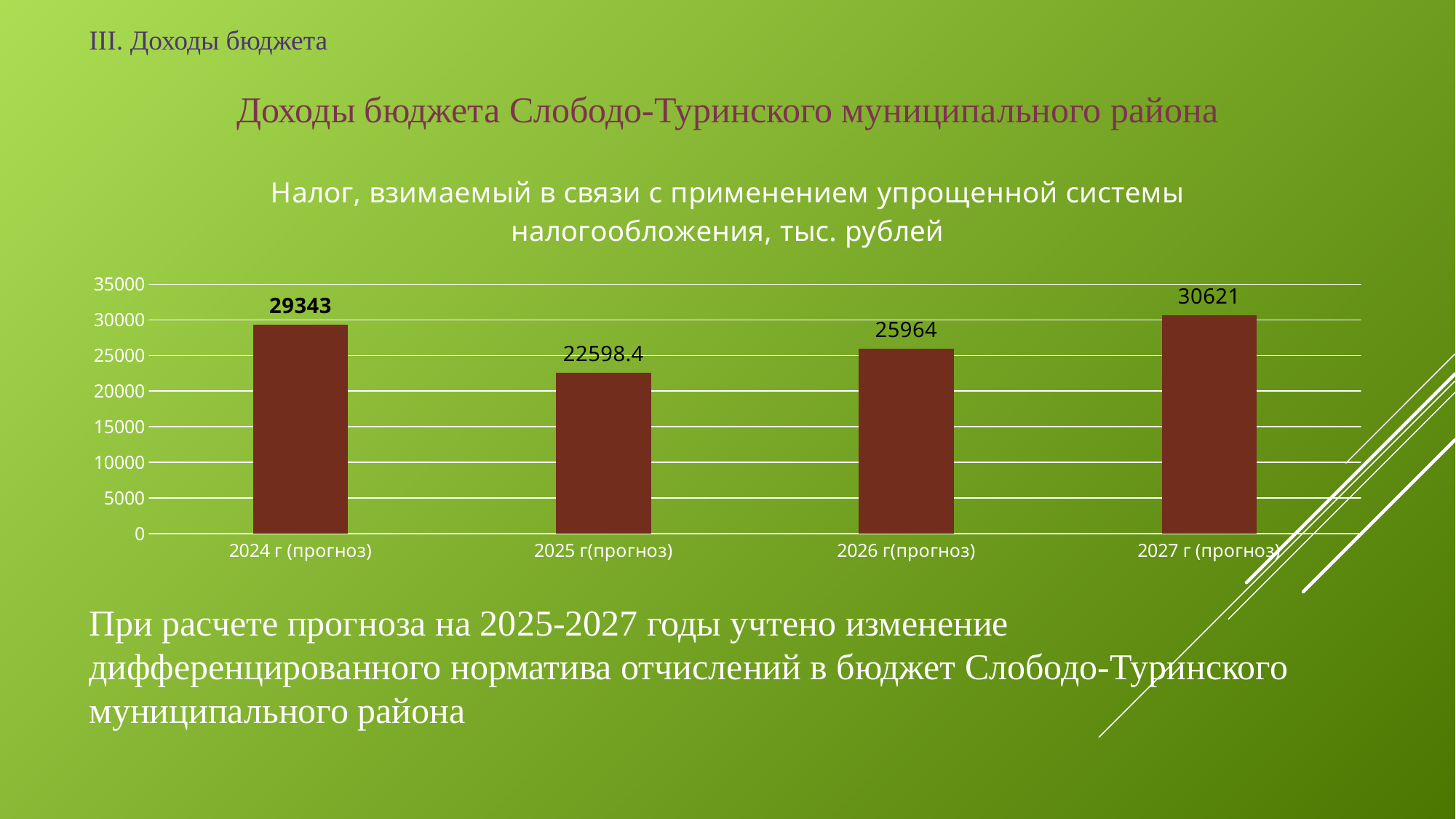
What is the value for 2027 г (прогноз)? 30621 How many bars are shown in the chart? 4 Which year has the highest value? 2027 г (прогноз) What is the value for 2025 г(прогноз)? 22598.4 What is the value for 2026 г(прогноз)? 25964 What is the difference between the values for 2027 г (прогноз) and 2024 г (прогноз)? 1278 What is the difference between the values for 2026 г(прогноз) and 2025 г(прогноз)? 3365.6 Which is larger, the value for 2024 г (прогноз) or 2026 г(прогноз)? 2024 г (прогноз) Which year has the lowest value? 2025 г(прогноз) What is the value for 2024 г (прогноз)? 29343 What kind of chart is shown on the slide? bar chart What is the title of the chart? Налог, взимаемый в связи с применением упрощенной системы налогообложения, тыс. рублей